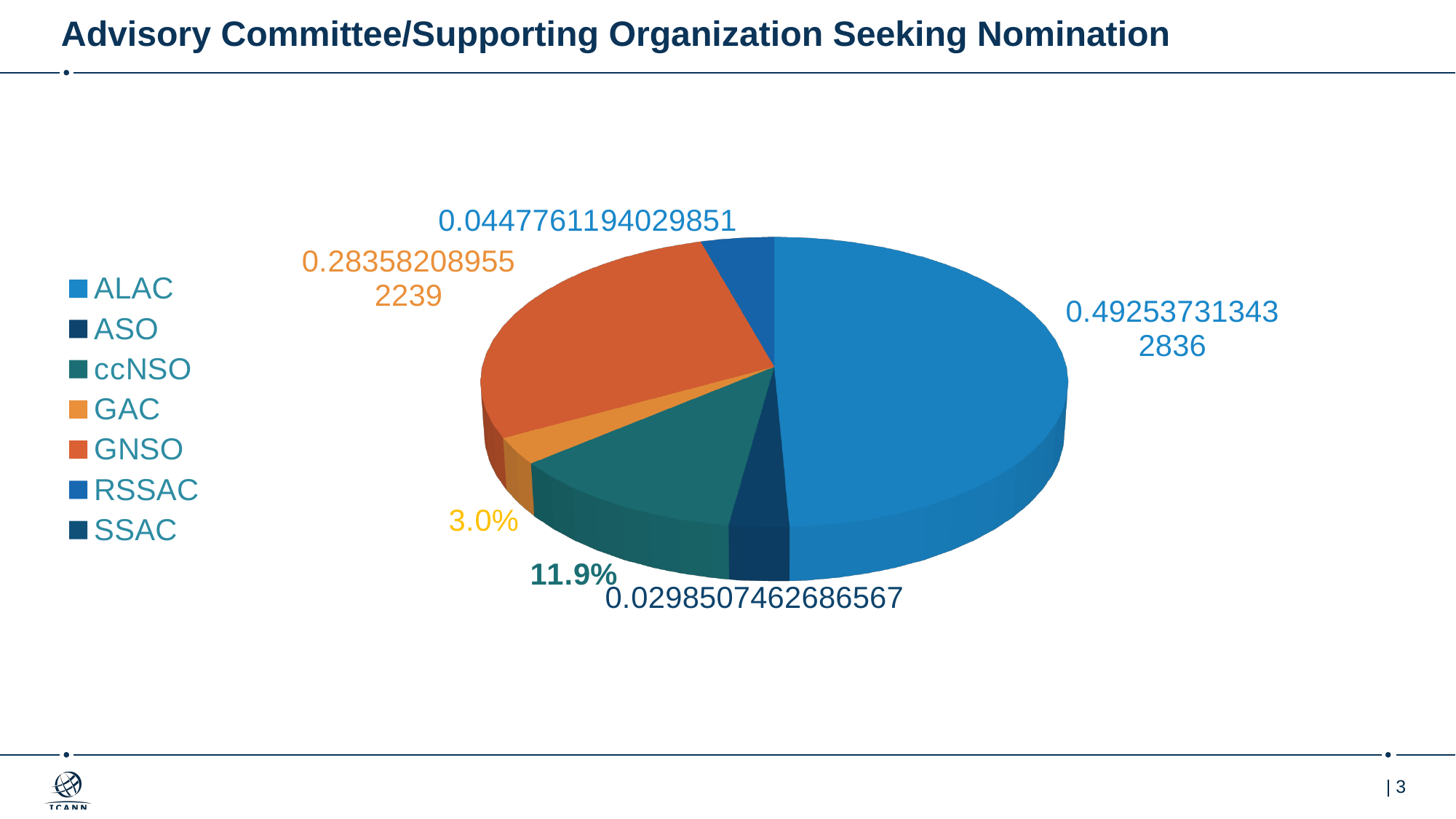
What value is labelled on the GAC slice? 3.0% What is the title of the chart on the slide? Advisory Committee/Supporting Organization Seeking Nomination Which category has the largest slice of the pie? ALAC How many entries does the chart's legend list? 7 What value is labelled on the ASO slice? 0.0298507462686567 What value is labelled on the RSSAC slice? 0.0447761194029851 Which slice is larger, GNSO or ccNSO? GNSO What value is labelled on the ALAC slice? 0.492537313432836 Which slice is larger, ccNSO or RSSAC? ccNSO What kind of chart is shown on the slide? Pie chart What value is labelled on the ccNSO slice? 11.9% What value is labelled on the GNSO slice? 0.283582089552239